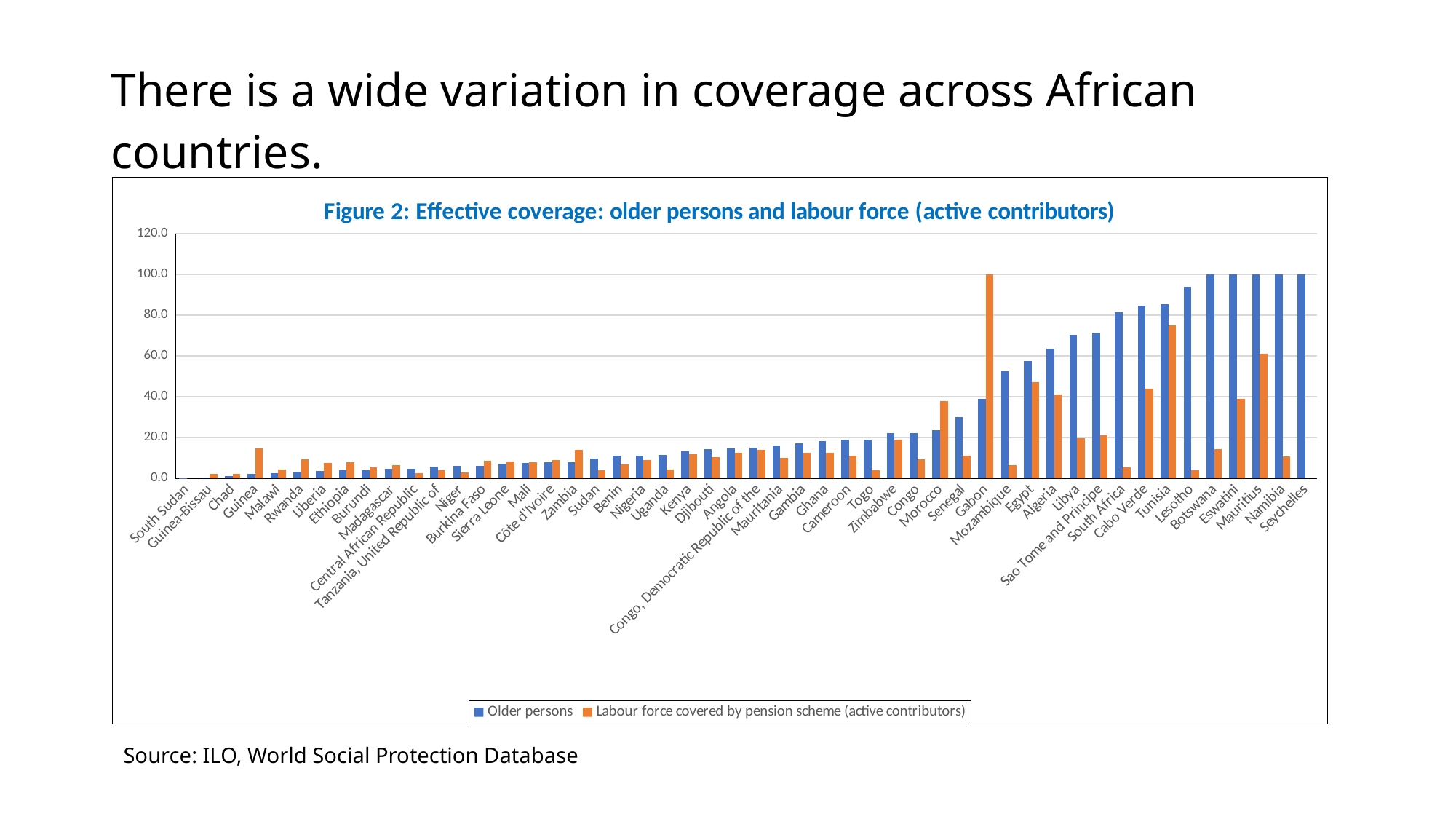
Do the Older persons values generally rise or fall moving from left to right along the x axis? rise What kind of chart is shown on the slide? bar chart How many series does the legend list? 2 For Gabon, which is larger: the Older persons value or the Labour force covered by pension scheme (active contributors) value? Labour force covered by pension scheme (active contributors) Is the Labour force covered by pension scheme (active contributors) value for Mozambique greater or less than 20.0? less What is the Older persons value for Seychelles? 100.0 What colour are the Older persons bars? blue How many countries are shown on the x axis? 50 Is the Older persons value for Egypt greater or less than 40.0? greater What is the Labour force covered by pension scheme (active contributors) value for Gabon? 100.0 Is the Older persons value for Lesotho greater or less than 80.0? greater Which country has the highest Labour force covered by pension scheme (active contributors) value? Gabon